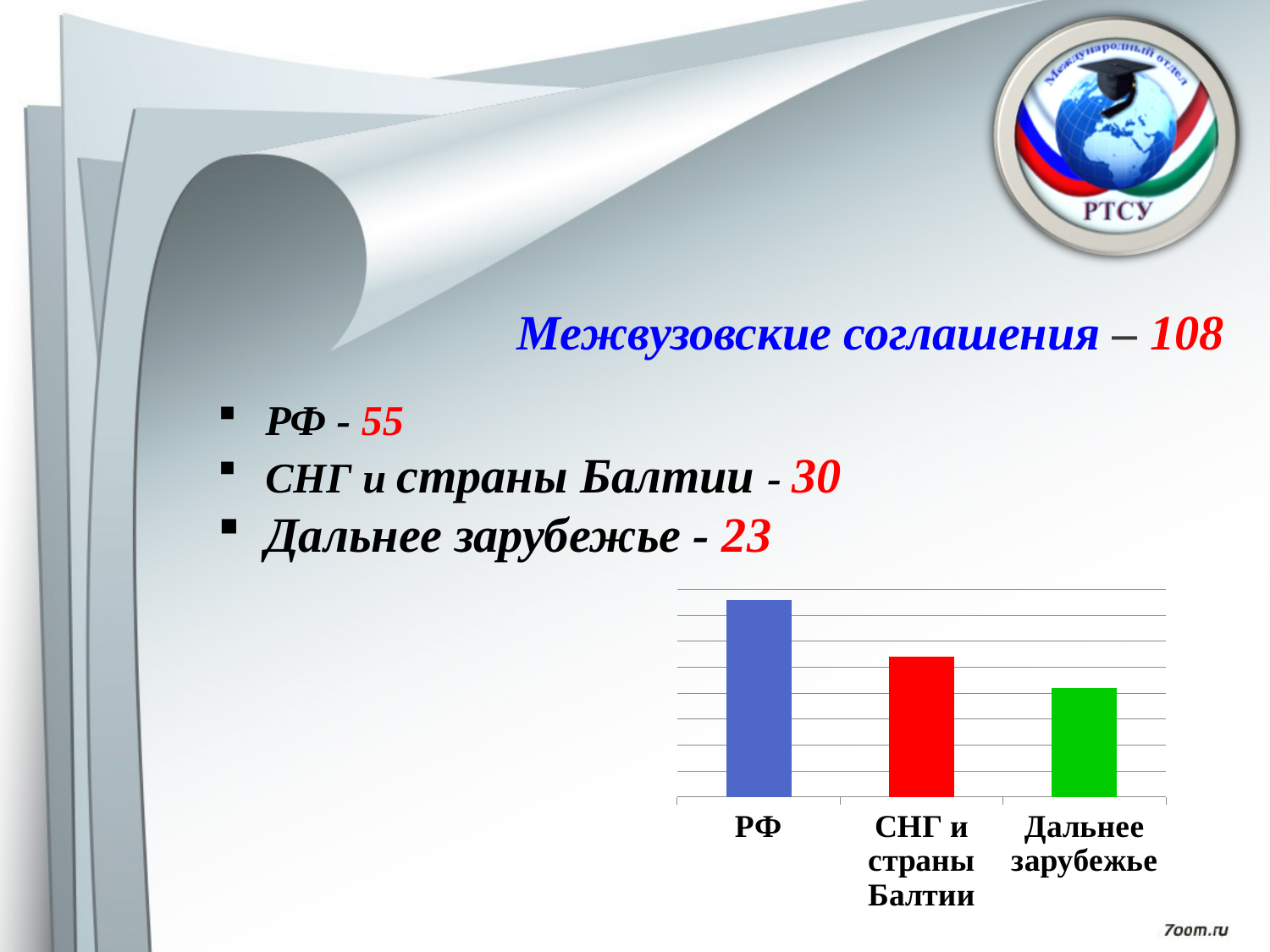
Do the bar heights rise or fall from left to right across the categories? fall According to the slide, what is the value for СНГ и страны Балтии? 30 What kind of chart is shown on the slide? bar chart Which category has the highest bar in the chart? РФ How many categories does the bar chart show? 3 Which category has the lowest bar in the chart? Дальнее зарубежье According to the slide, what is the value for Дальнее зарубежье? 23 Which is larger, the bar for РФ or the bar for СНГ и страны Балтии? РФ What is the difference between the values for РФ and Дальнее зарубежье shown on the slide? 32 Which is larger, the bar for СНГ и страны Балтии or the bar for Дальнее зарубежье? СНГ и страны Балтии According to the slide, what is the value for РФ? 55 What colour is the bar for СНГ и страны Балтии? red